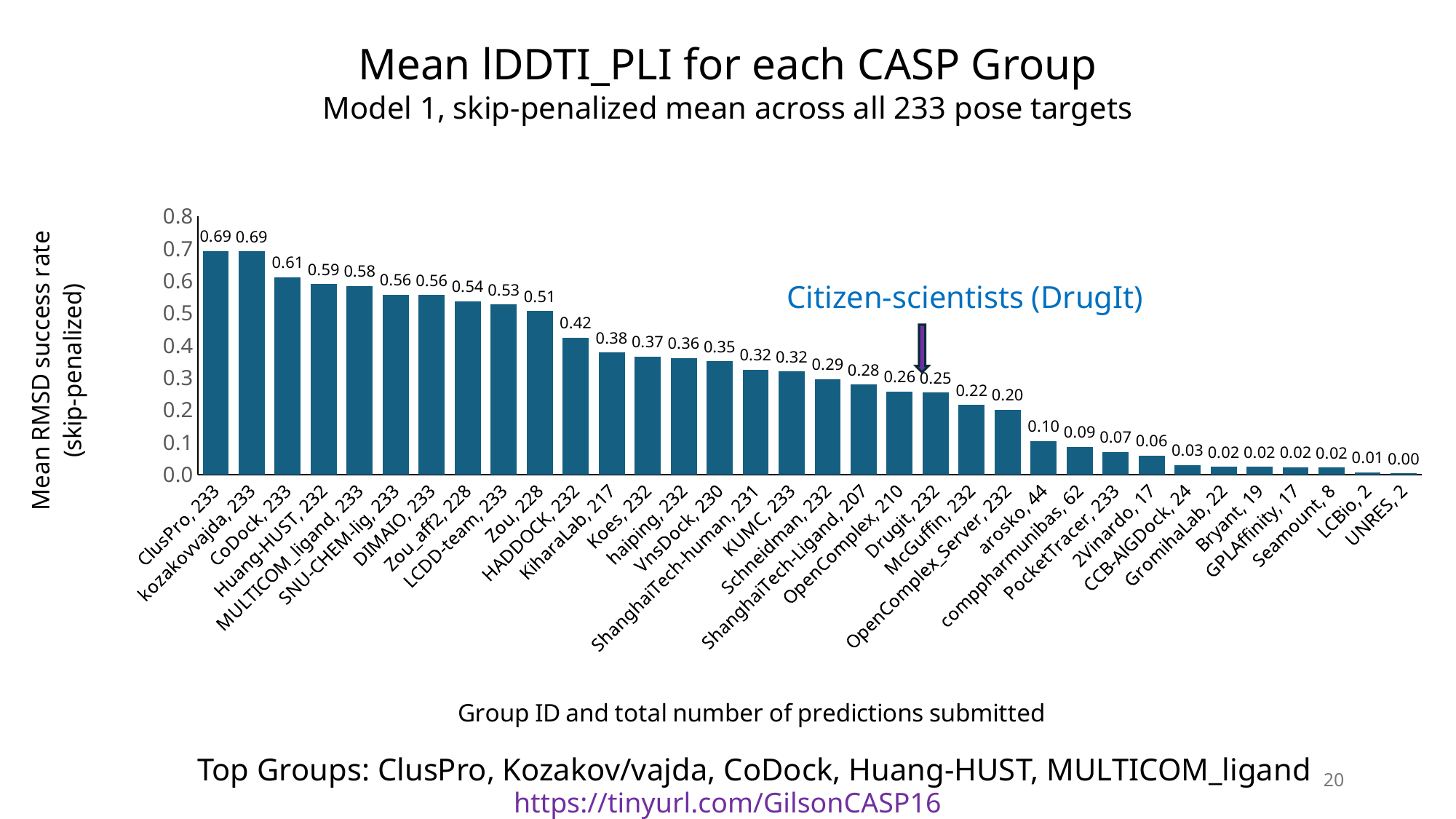
Which is larger, the value for Koes, 232 or the value for KUMC, 233? Koes, 232 Which group has the lowest value? UNRES, 2 What is the value for HADDOCK, 232? 0.42 What is the value for arosko, 44? 0.10 What is the value for CoDock, 233? 0.61 Do the values rise or fall from left to right along the x axis? fall What kind of chart is this? bar chart Is the value for McGuffin, 232 greater or less than 0.3? less What is the difference between the values for ClusPro, 233 and CoDock, 233? 0.08 Which group does the arrow labelled 'Citizen-scientists (DrugIt)' point to? Drugit, 232 How many groups are shown on the x axis? 34 What is the value for Drugit, 232? 0.25